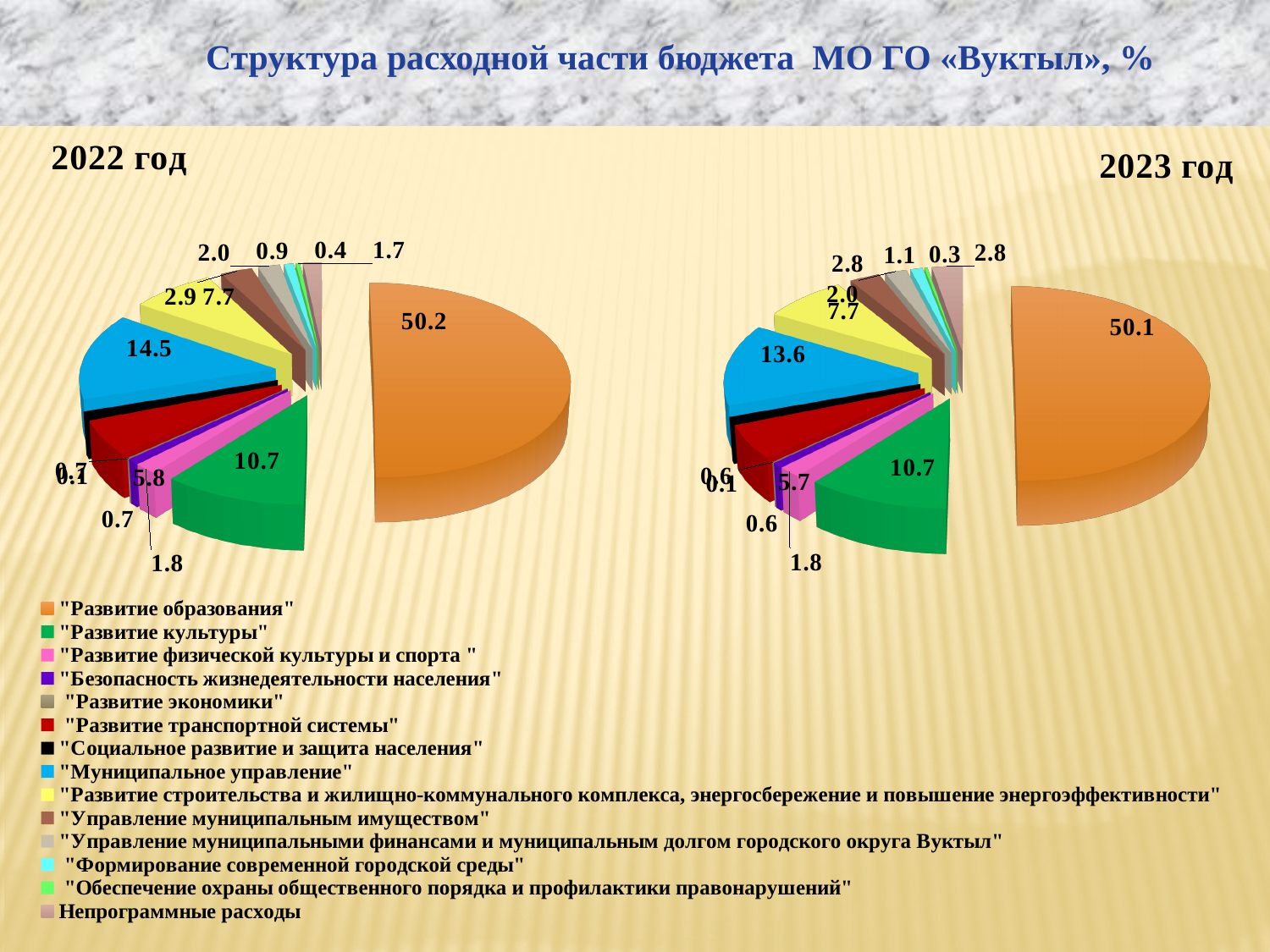
On the 2023 pie chart, what is the value for "Развитие культуры"? 10.7 On the 2023 pie chart, what is the value for "Муниципальное управление"? 13.6 What is the title of the slide? Структура расходной части бюджета МО ГО «Вуктыл», % On the 2022 pie chart, which is larger: "Развитие культуры" or "Муниципальное управление"? "Муниципальное управление" How many categories does the legend list? 14 On the 2023 pie chart, what is the value for "Развитие образования"? 50.1 What is the difference between the "Муниципальное управление" value on the 2022 chart and on the 2023 chart? 0.9 What is the difference between the "Развитие образования" value on the 2022 chart and on the 2023 chart? 0.1 On the 2022 pie chart, what is the value for "Муниципальное управление"? 14.5 On the 2022 pie chart, what is the value for "Развитие образования"? 50.2 What kind of charts are shown on the slide? Pie charts On the 2022 pie chart, which category has the largest slice? "Развитие образования"